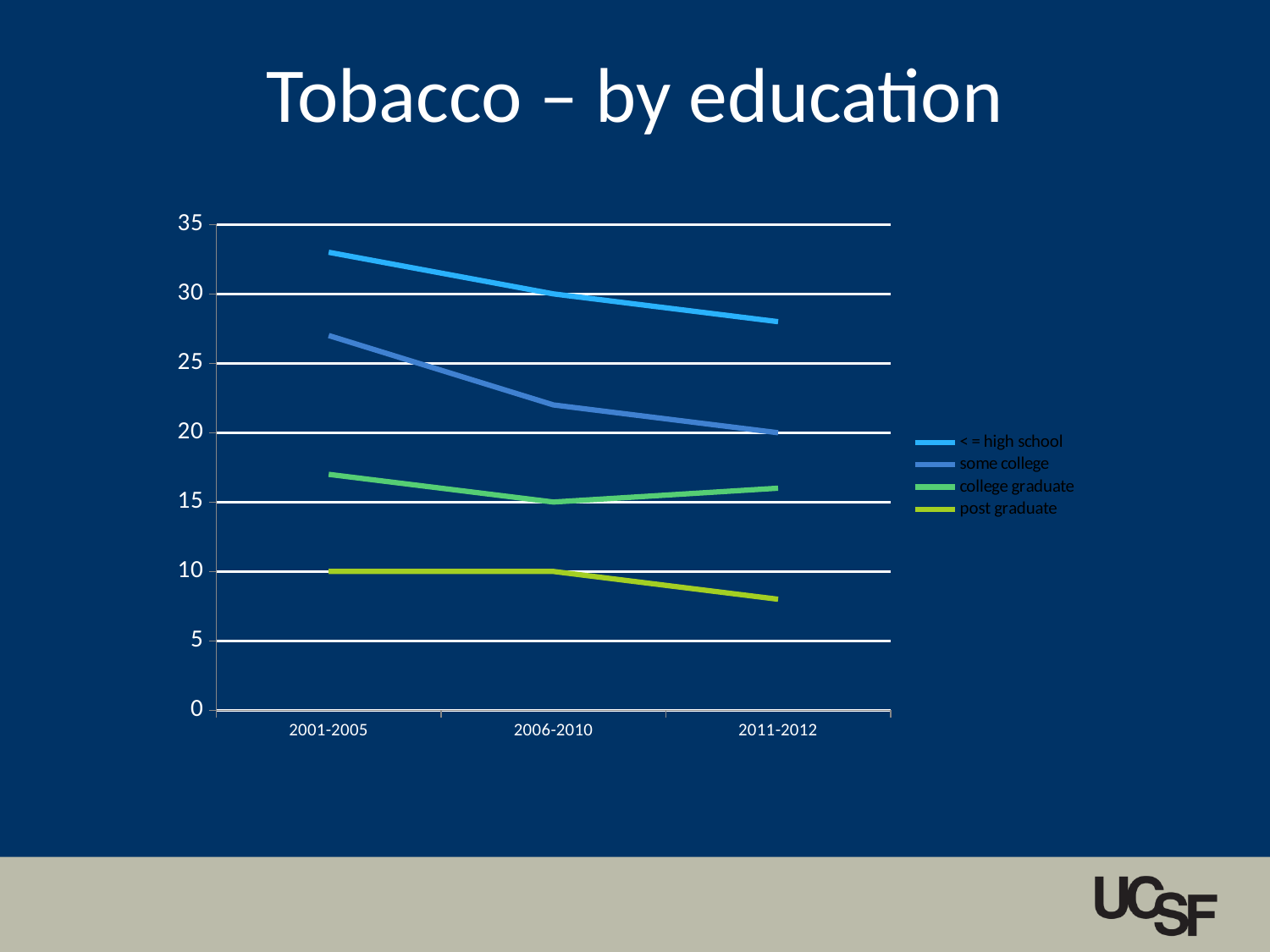
What is the value for post graduate in 2001-2005? 10 Which education group has the lowest values across all periods? post graduate How many series does the legend list? 4 Does the < = high school line rise or fall from 2001-2005 to 2011-2012? fall Is the value for some college in 2001-2005 greater or less than 25? greater How many time periods are shown on the x axis? 3 Is the value for post graduate in 2011-2012 greater or less than 10? less Which education group has the highest values across all periods? < = high school What is the value for college graduate in 2006-2010? 15 What is the value for some college in 2011-2012? 20 Is the value for < = high school in 2001-2005 greater or less than 30? greater What kind of chart is shown on the slide? line chart